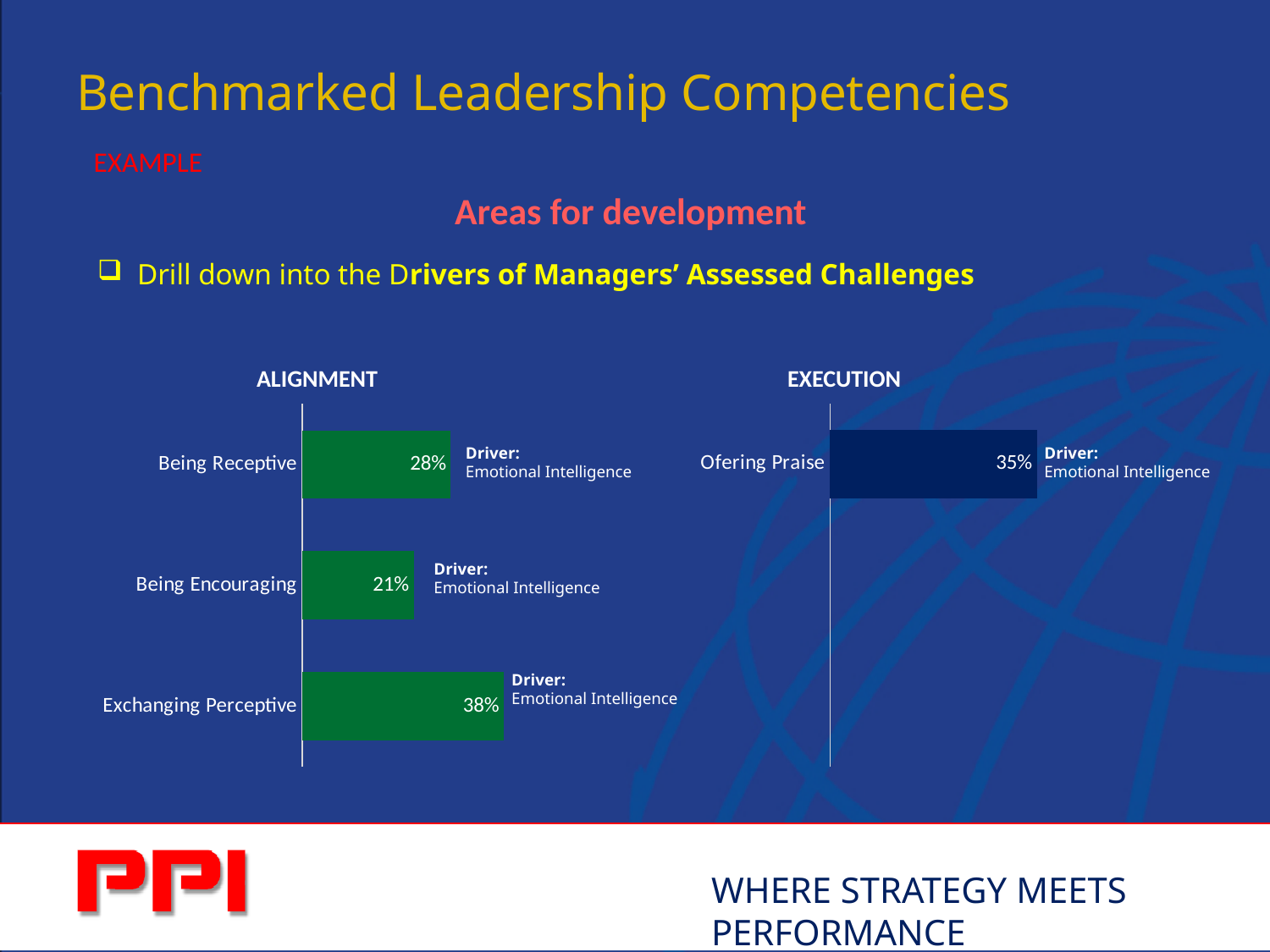
What driver is listed next to the Ofering Praise bar in the EXECUTION chart? Emotional Intelligence In the EXECUTION chart, what is the value for Ofering Praise? 35% In the ALIGNMENT chart, which category has the highest value? Exchanging Perceptive In the ALIGNMENT chart, what is the difference between Exchanging Perceptive and Being Encouraging? 17% In the ALIGNMENT chart, what is the value for Exchanging Perceptive? 38% How many categories are shown in the EXECUTION chart? 1 In the ALIGNMENT chart, what is the value for Being Encouraging? 21% What kind of chart is the ALIGNMENT chart? Bar chart In the ALIGNMENT chart, which category has the lowest value? Being Encouraging In the ALIGNMENT chart, which is larger, Being Receptive or Being Encouraging? Being Receptive In the ALIGNMENT chart, what is the value for Being Receptive? 28% How many categories are shown in the ALIGNMENT chart? 3